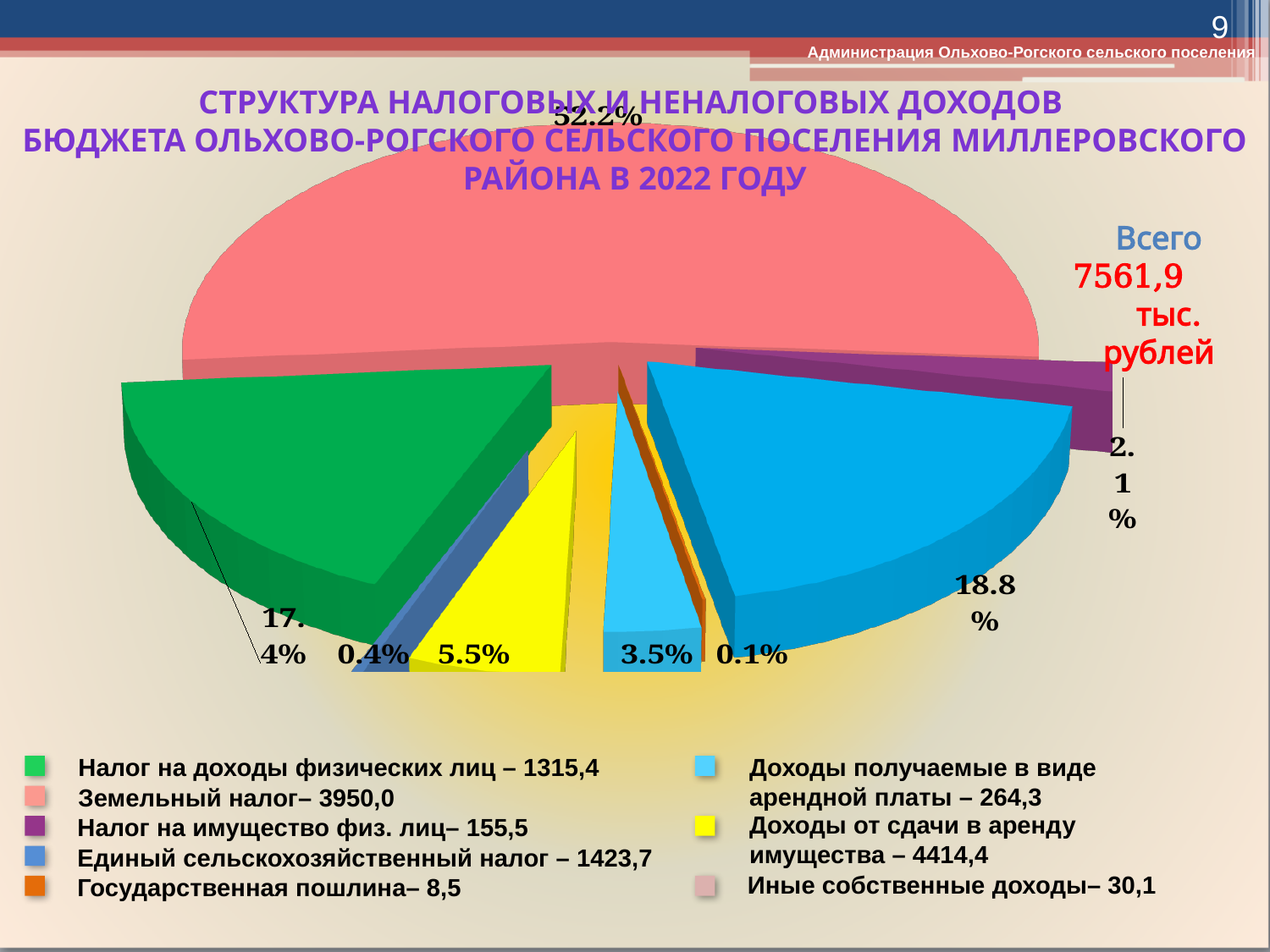
How many entries does the legend list? 8 What kind of chart is shown on the slide? pie chart What total amount (Всего) is shown next to the pie chart? 7561,9 тыс. рублей What value does the legend give for Земельный налог? 3950,0 Which is larger, the slice labelled 18.8% or the slice labelled 17.4%? 18.8% What is the difference in percentage points between the 52.2% slice and the 18.8% slice? 33.4 What share of the pie does the green slice (Налог на доходы физических лиц) represent? 17.4% How many percentage labels are shown on the pie chart? 8 What is the smallest percentage labelled on the pie chart? 0.1% What value does the legend give for Налог на доходы физических лиц? 1315,4 What is the largest percentage shown on the pie chart? 52.2% What value does the legend give for Государственная пошлина? 8,5